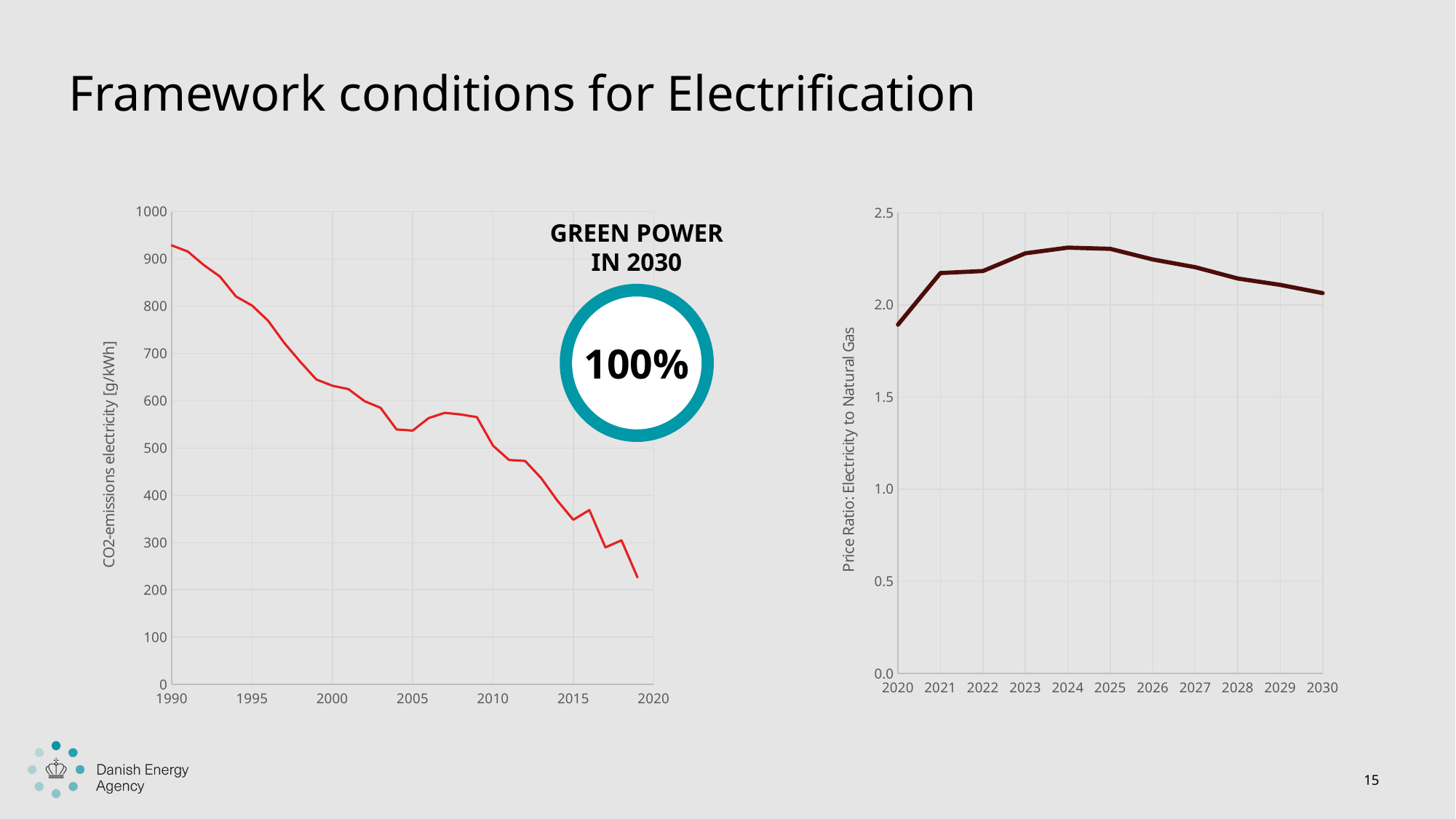
In the left chart (CO2-emissions electricity), is the value for 2000 greater or less than 600? greater What is the y-axis label of the left chart? CO2-emissions electricity [g/kWh] In the right chart (Price Ratio: Electricity to Natural Gas), is the value for 2020 greater or less than 2.0? less What kind of chart is the left chart showing CO2-emissions electricity [g/kWh]? line chart In the left chart (CO2-emissions electricity), do the values generally rise or fall from 1990 to 2020? fall In the left chart (CO2-emissions electricity), is the value for 1990 greater or less than 900? greater In the right chart (Price Ratio: Electricity to Natural Gas), do the values rise or fall from 2025 to 2030? fall What kind of chart is the right chart showing Price Ratio: Electricity to Natural Gas? line chart How many years are labelled on the x axis of the right chart (Price Ratio: Electricity to Natural Gas)? 11